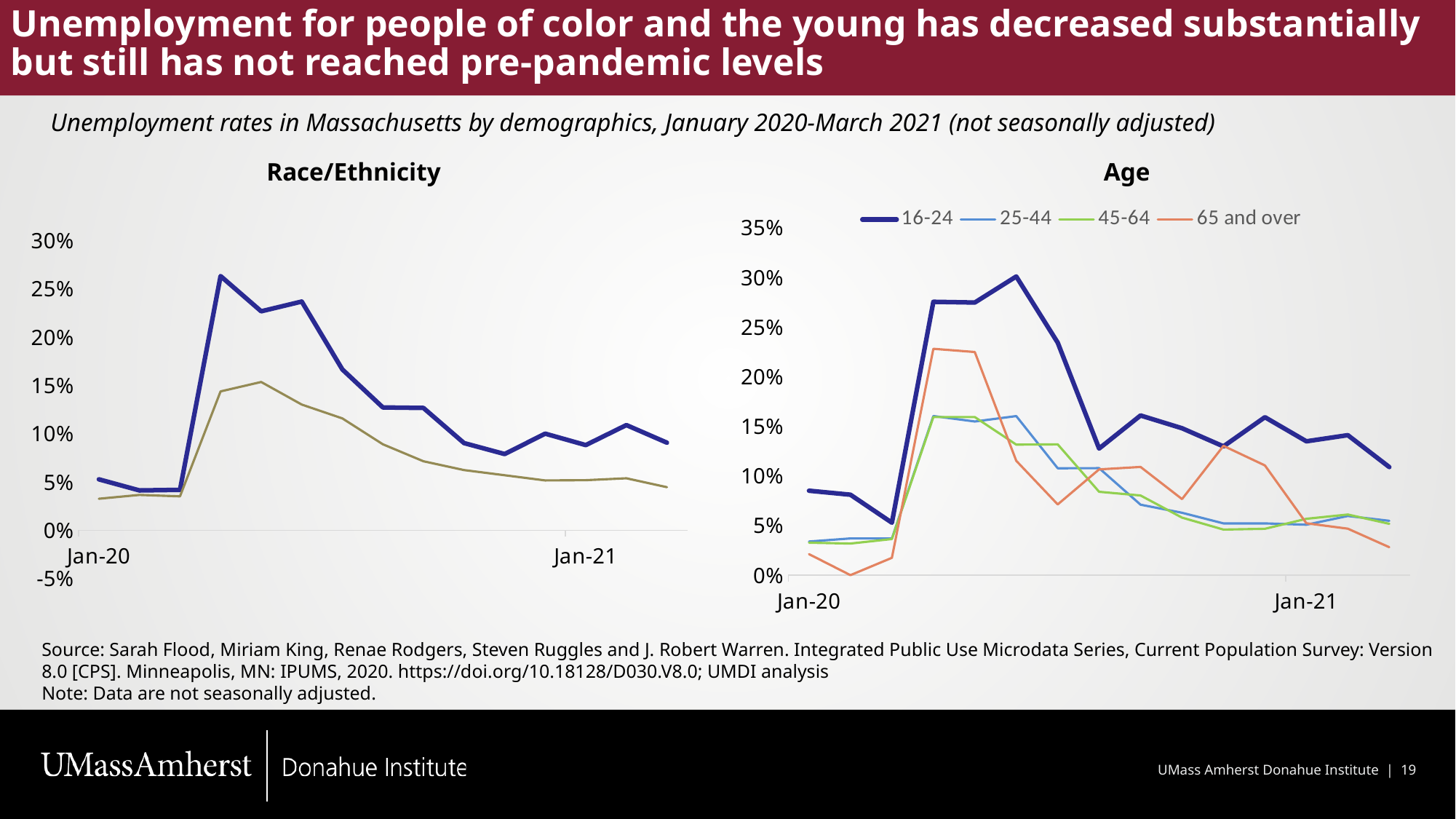
In the Age chart, which age group has the lowest unemployment rate at the final point (March 2021)? 65 and over In the Age chart, which age group has the highest unemployment rate at the final point (March 2021)? 16-24 In the Age chart, is the peak value for the 65 and over group greater or less than 20%? greater In the Age chart, is the peak value for the 16-24 group greater or less than 25%? greater What kind of chart is the Age chart? Line chart How many series does the legend of the Age chart list? 4 In the Age chart, which age group is listed first in the legend? 16-24 In the Race/Ethnicity chart, is the peak value of the olive line greater or less than 20%? less What kind of chart is the Race/Ethnicity chart? Line chart In the Age chart, which age group reaches the highest unemployment rate at its peak? 16-24